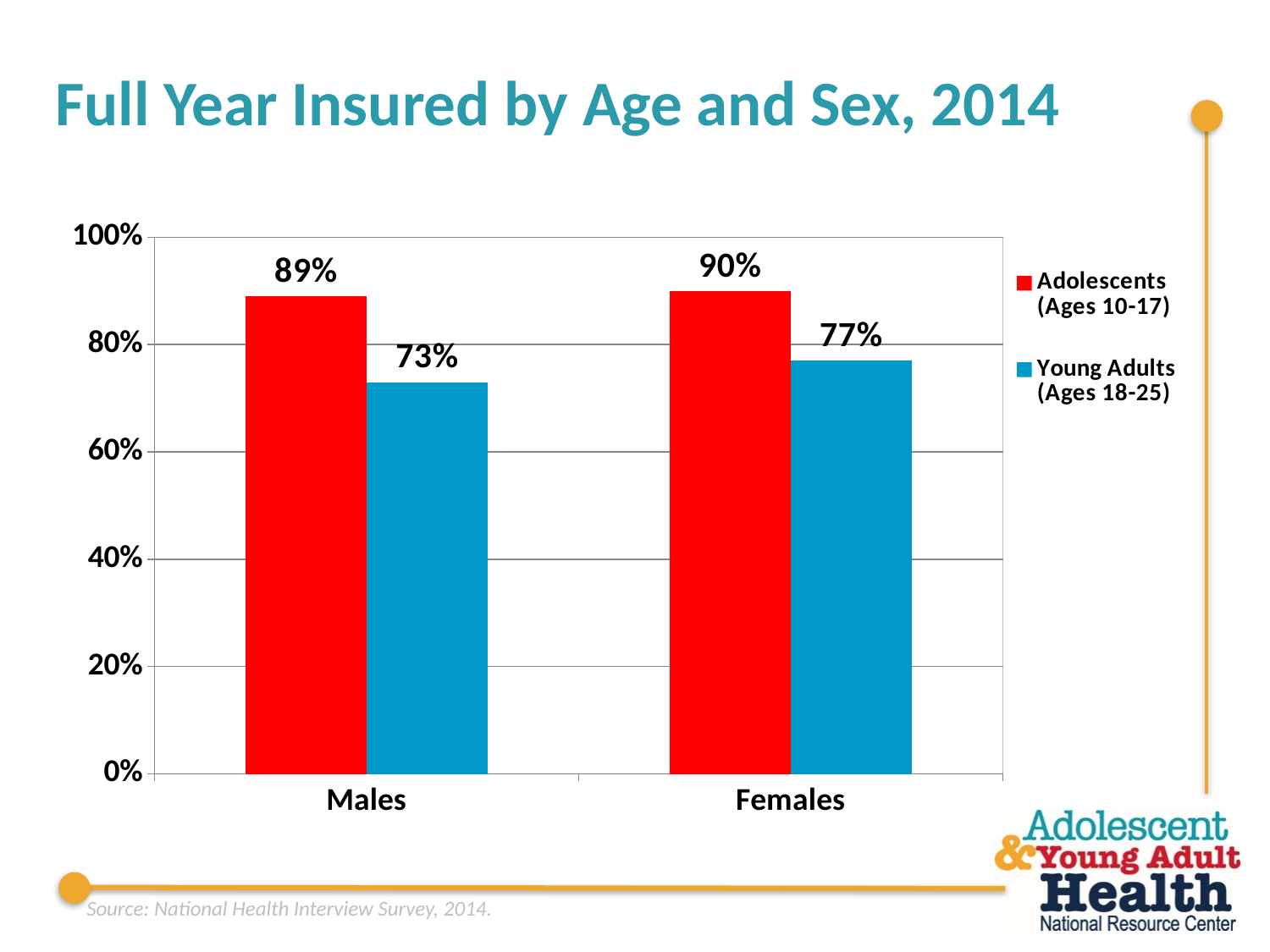
What is the difference between Adolescents and Young Adults among Females? 13% What is the value for Young Adults (Ages 18-25) among Females? 77% How many series does the legend list? 2 Which group has the lowest value on the chart? Young Adults (Ages 18-25), Males Is the value for Young Adults among Males greater or less than 80%? less What is the value for Adolescents (Ages 10-17) among Males? 89% Which is larger: the Young Adults value for Males or for Females? Females What kind of chart is shown on the slide? bar chart What is the difference between Adolescents and Young Adults among Males? 16% How many categories are shown on the x axis? 2 What is the value for Young Adults (Ages 18-25) among Males? 73% Which group has the highest value on the chart? Adolescents (Ages 10-17), Females